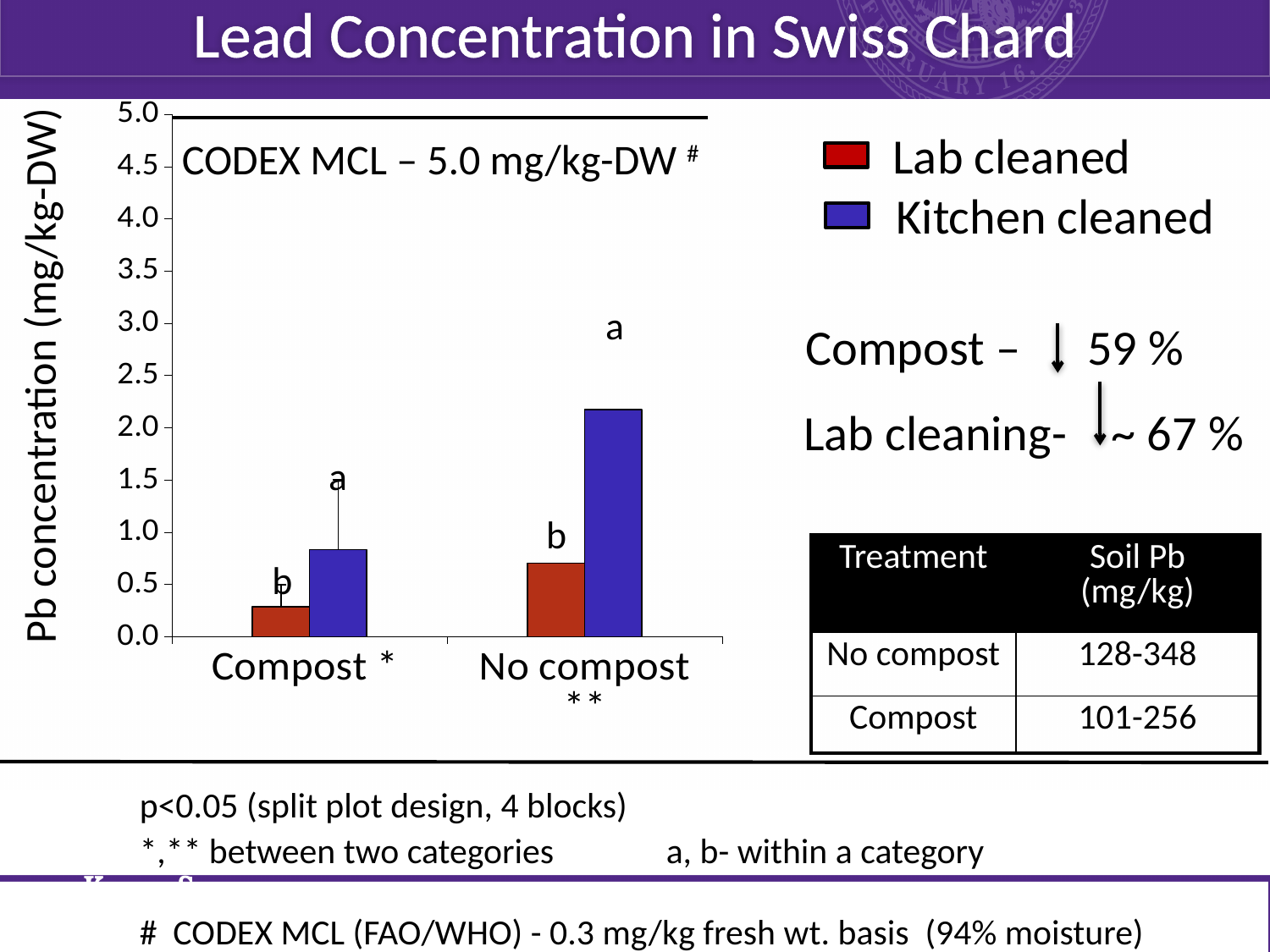
Which category and series has the highest bar in the chart? Kitchen cleaned, No compost Which category and series has the lowest bar in the chart? Lab cleaned, Compost What colour represents the Lab cleaned series in the chart? red Is the Kitchen cleaned value for Compost greater or less than 1.0? less In the No compost category, which is larger: Lab cleaned or Kitchen cleaned? Kitchen cleaned How many series does the chart legend list? 2 Is the Kitchen cleaned value for No compost greater or less than 1.5? greater Do the Kitchen cleaned values rise or fall from Compost to No compost? rise What type of chart is shown on the slide? bar chart How many categories are shown on the x axis of the chart? 2 Is the Lab cleaned value for Compost greater or less than 0.5? less What is the title of the chart? Lead Concentration in Swiss Chard